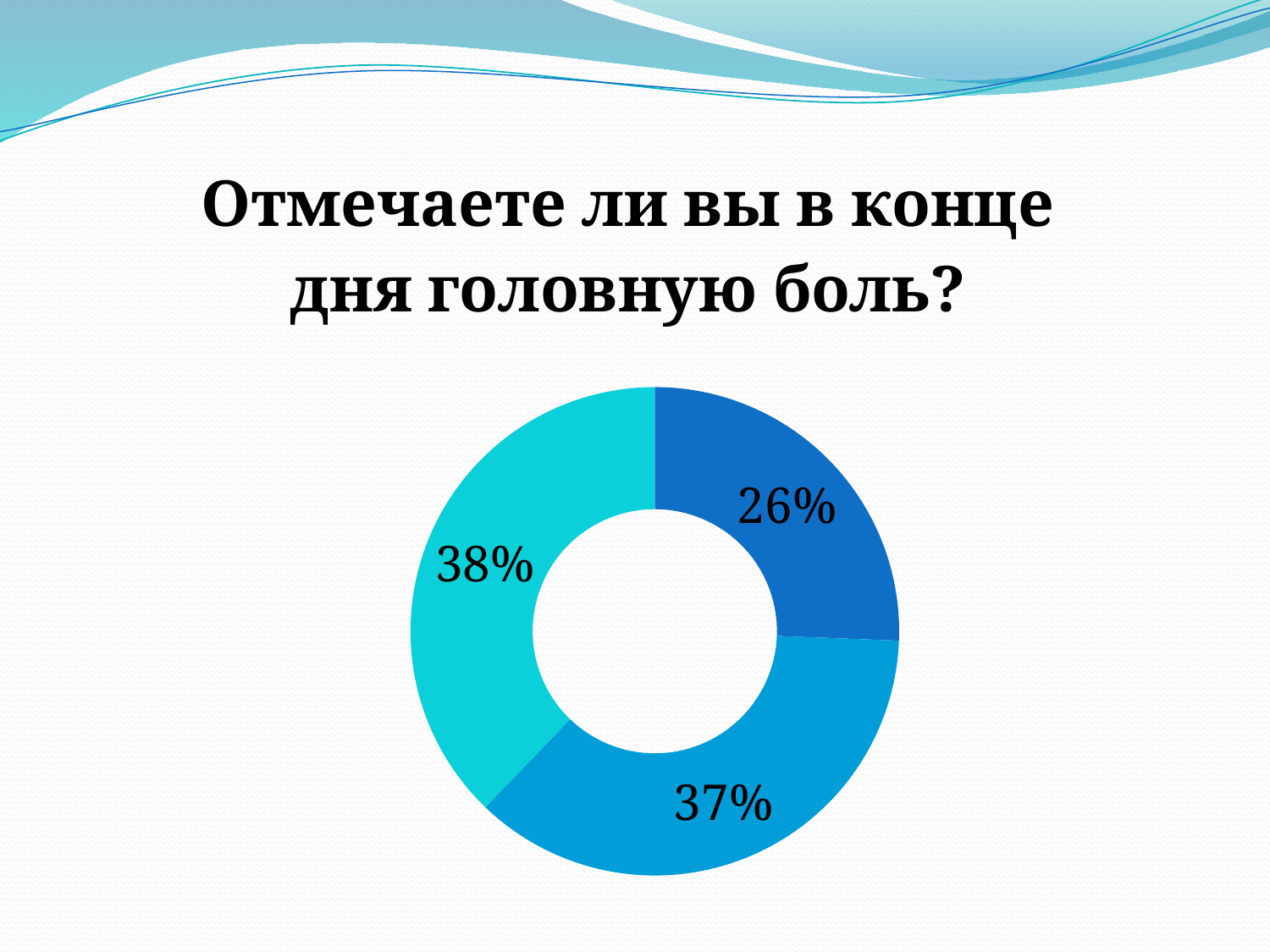
Does the doughnut chart have a legend? No What is the difference between the 38% slice and the 26% slice? 12% What is the difference between the 37% slice and the 26% slice? 11% What is the title of the slide above the chart? Отмечаете ли вы в конце дня головную боль? Which slice has the largest share in the doughnut chart? The teal slice (38%) What is the value shown on the slice at the bottom of the doughnut chart? 37% What is the value shown on the teal slice on the left side of the doughnut chart? 38% Which slice has the smallest share in the doughnut chart? The dark blue slice (26%) What is the value shown on the dark blue slice of the doughnut chart? 26% What kind of chart is shown on the slide? Doughnut chart How many slices does the doughnut chart have? 3 Which is larger, the bottom slice or the dark blue slice? The bottom slice (37%)